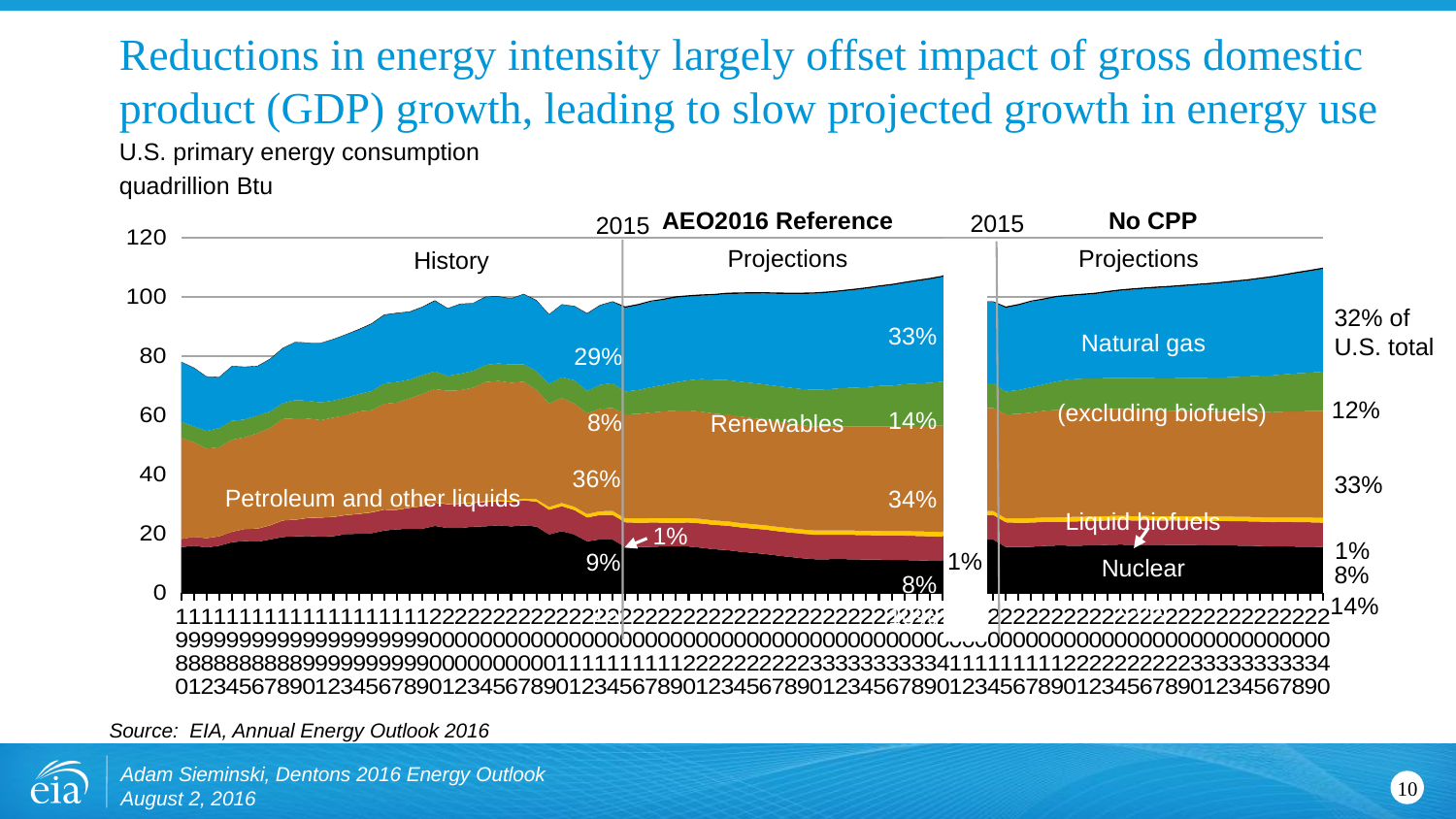
In the No CPP panel, what share of the U.S. total does natural gas account for at the end of the projection period? 32% Is total U.S. primary energy consumption in 2015 greater or less than 80 quadrillion Btu? greater In the AEO2016 Reference panel, what share do renewables (excluding biofuels) account for in 2015? 8% In the No CPP panel, what share does nuclear account for at the end of the projection period? 8% In the AEO2016 Reference panel, what share of U.S. primary energy consumption does natural gas account for in 2015? 29% In the AEO2016 Reference panel, what share does natural gas reach at the end of the projection period? 33% What kind of chart is shown on the slide? Stacked area chart At the end of the projection period, is the renewables share larger in the AEO2016 Reference case or the No CPP case? AEO2016 Reference In the AEO2016 Reference panel, what share do renewables reach at the end of the projection period? 14% What is the unit of measurement shown on the y axis of the chart? quadrillion Btu By how many percentage points does the natural gas share rise from 2015 to the end of the projection in the AEO2016 Reference panel? 4 percentage points In the AEO2016 Reference panel, what share does petroleum and other liquids account for in 2015? 36%